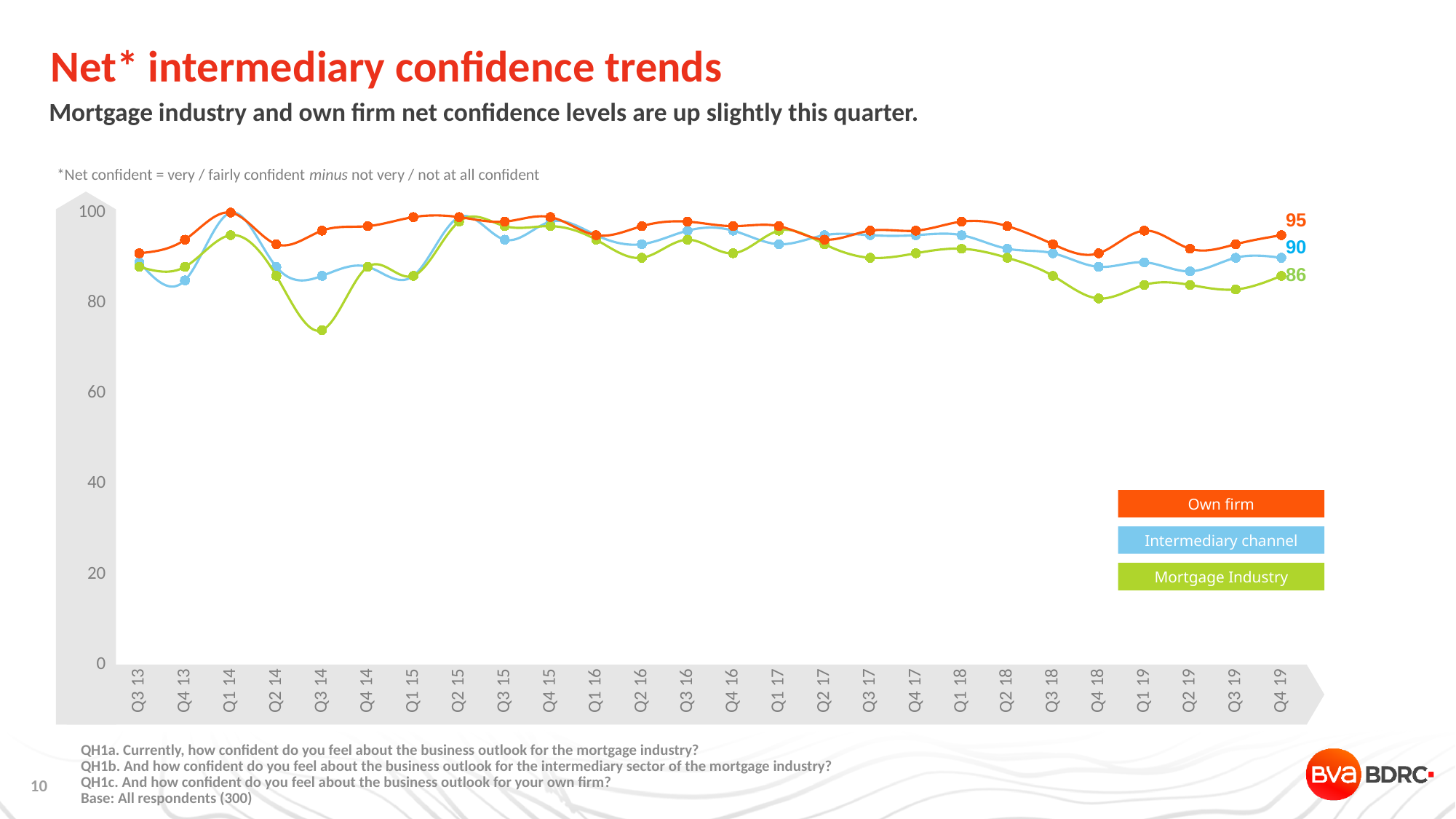
What is the Intermediary channel net confidence value for Q4 19? 90 Is the Mortgage Industry value for Q3 14 greater or less than 80? less Which series has the highest value at Q4 19? Own firm What is the Mortgage Industry net confidence value for Q4 19? 86 What is the Own firm net confidence value for Q4 19? 95 How many series does the legend list? 3 Is the Own firm value for Q1 14 greater or less than 80? greater Which series has the lowest value at Q4 19? Mortgage Industry Which colour represents the Intermediary channel series? Blue What is the difference between the Own firm and Mortgage Industry values at Q4 19? 9 What type of chart is shown on the slide? Line chart How many quarters are plotted along the x axis? 26